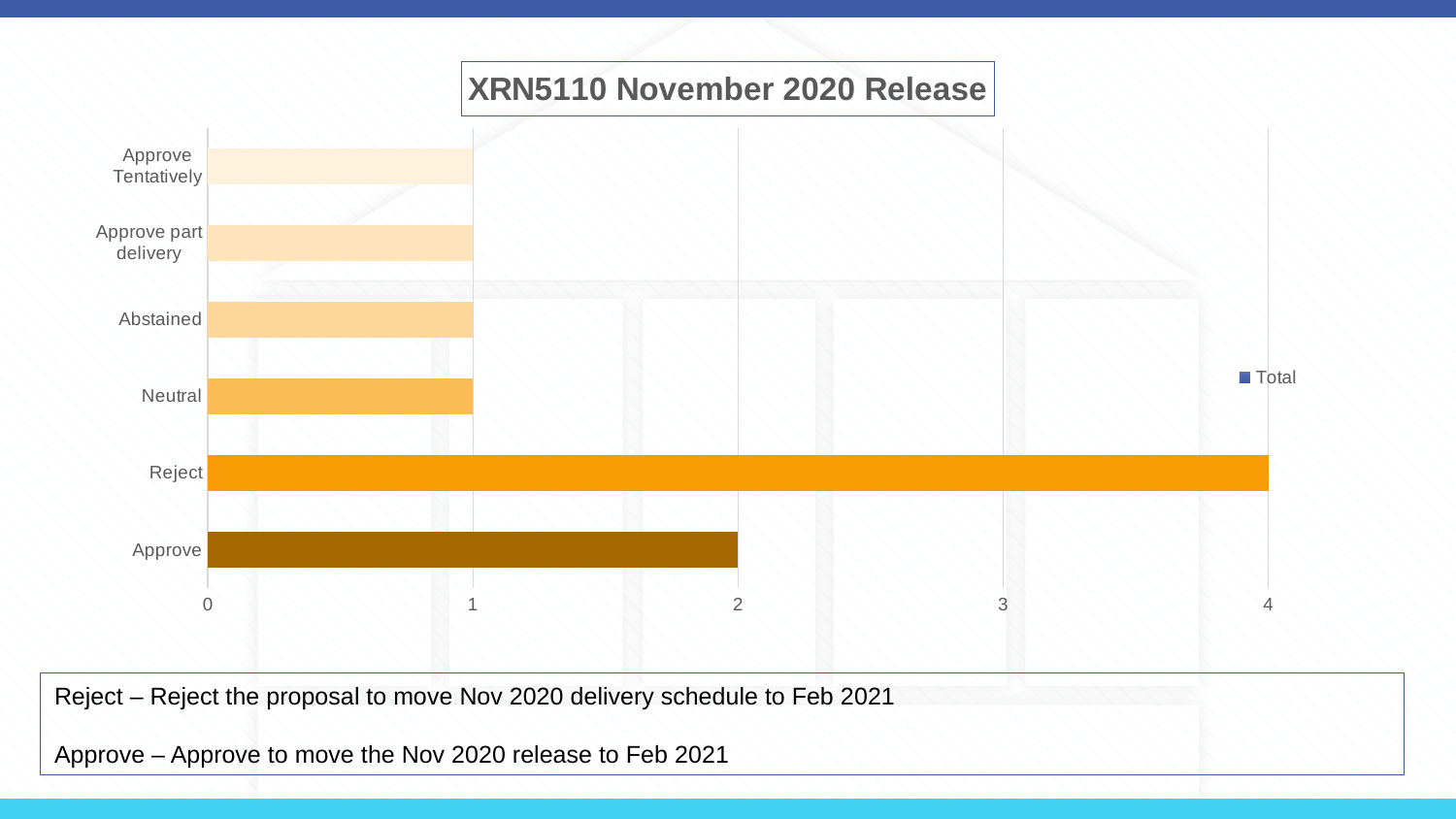
What type of chart is shown on the slide? bar chart What is the name of the series in the legend? Total How many series does the legend list? 1 How many categories are shown on the chart? 6 Which category has the highest value? Reject What is the value for Neutral? 1 What is the difference between the values for Reject and Approve? 2 What is the value for Approve? 2 Which is larger, the value for Approve or the value for Abstained? Approve What is the value for Reject? 4 Is the value for Reject greater or less than 3? greater What is the title of the chart? XRN5110 November 2020 Release